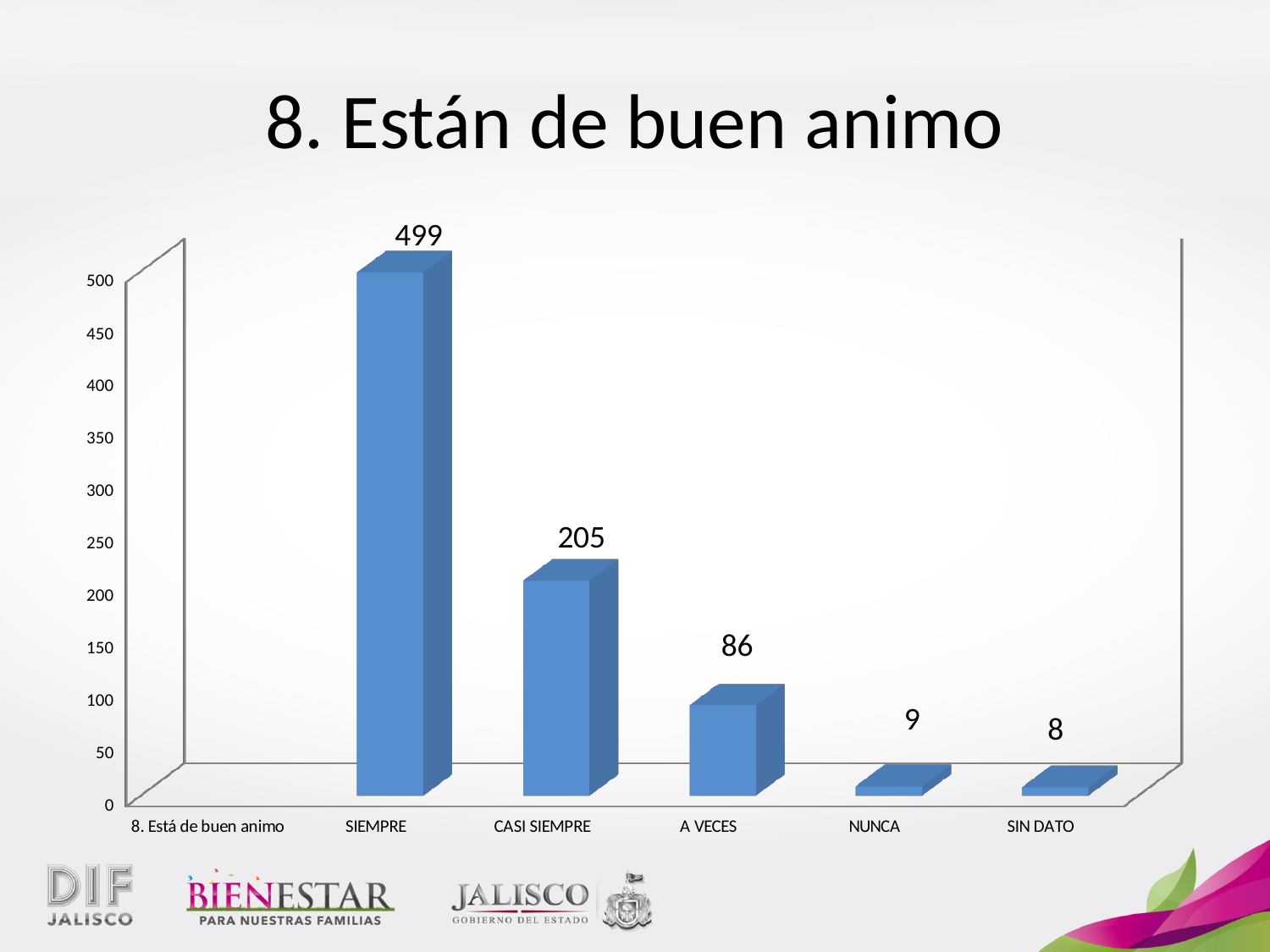
What is the title of the slide? 8. Están de buen animo What is the difference between the values for SIEMPRE and CASI SIEMPRE? 294 Which category has the lowest value? SIN DATO Which category has the highest value? SIEMPRE What kind of chart is shown on the slide? Bar chart What is the value for A VECES? 86 What is the value for SIN DATO? 8 What is the value for CASI SIEMPRE? 205 Which is larger, the value for CASI SIEMPRE or the value for A VECES? CASI SIEMPRE How many bars are plotted in the chart? 5 What is the value for SIEMPRE? 499 What is the value for NUNCA? 9